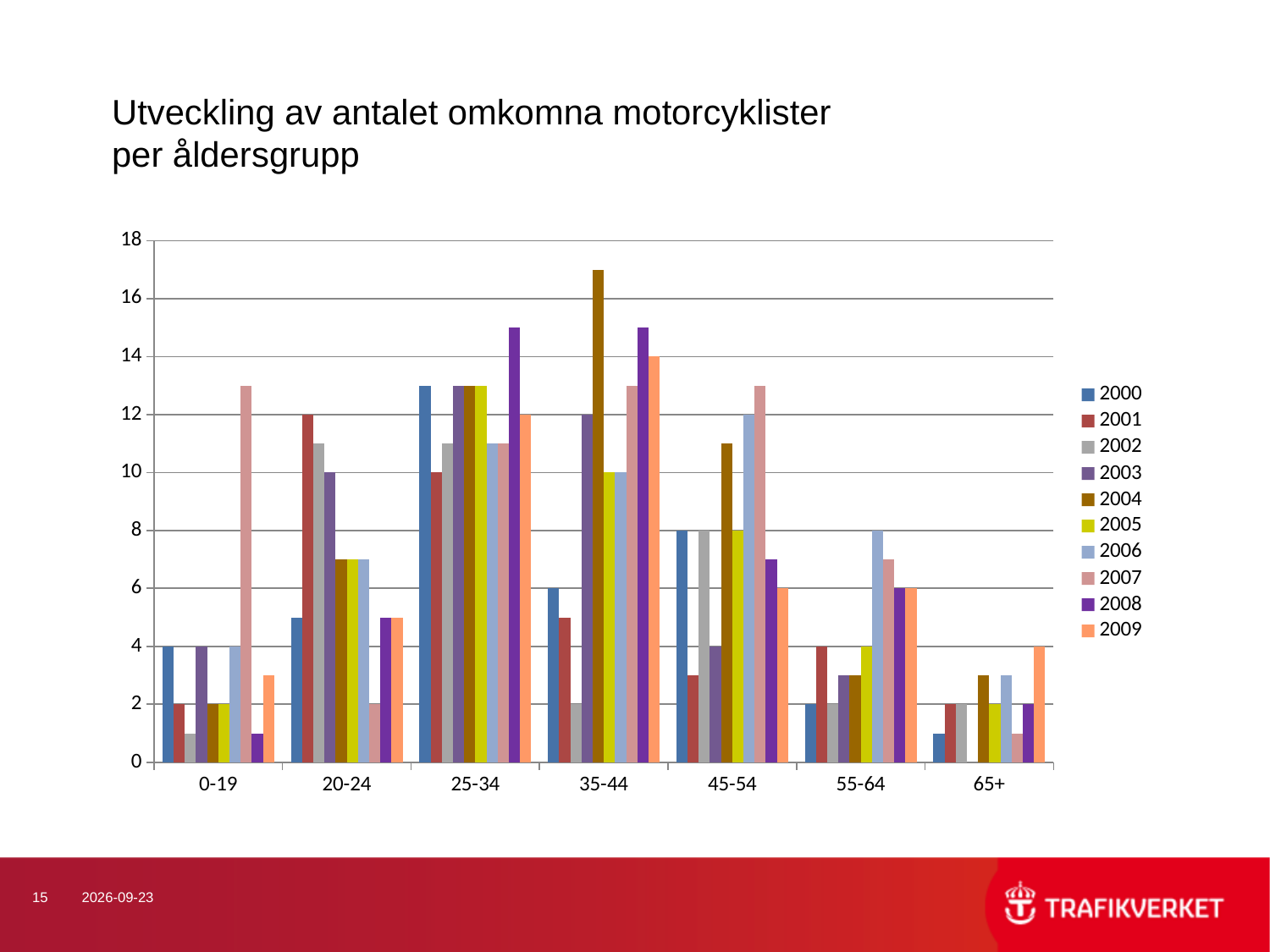
Which year has the lowest value in the 20-24 age group? 2007 Is the value for 2004 in the 35-44 age group greater or less than 16? greater What is the value for 2006 in the 55-64 age group? 8 What is the value for 2003 in the 35-44 age group? 12 How many series does the legend list? 10 Is the value for 2007 in the 0-19 age group greater or less than 12? greater What type of chart is shown on the slide? bar chart What is the value for 2001 in the 20-24 age group? 12 How many age groups are shown on the x axis? 7 What is the value for 2009 in the 65+ age group? 4 What is the difference between the 2003 and 2000 values in the 35-44 age group? 6 Which year has the highest value in the 0-19 age group? 2007